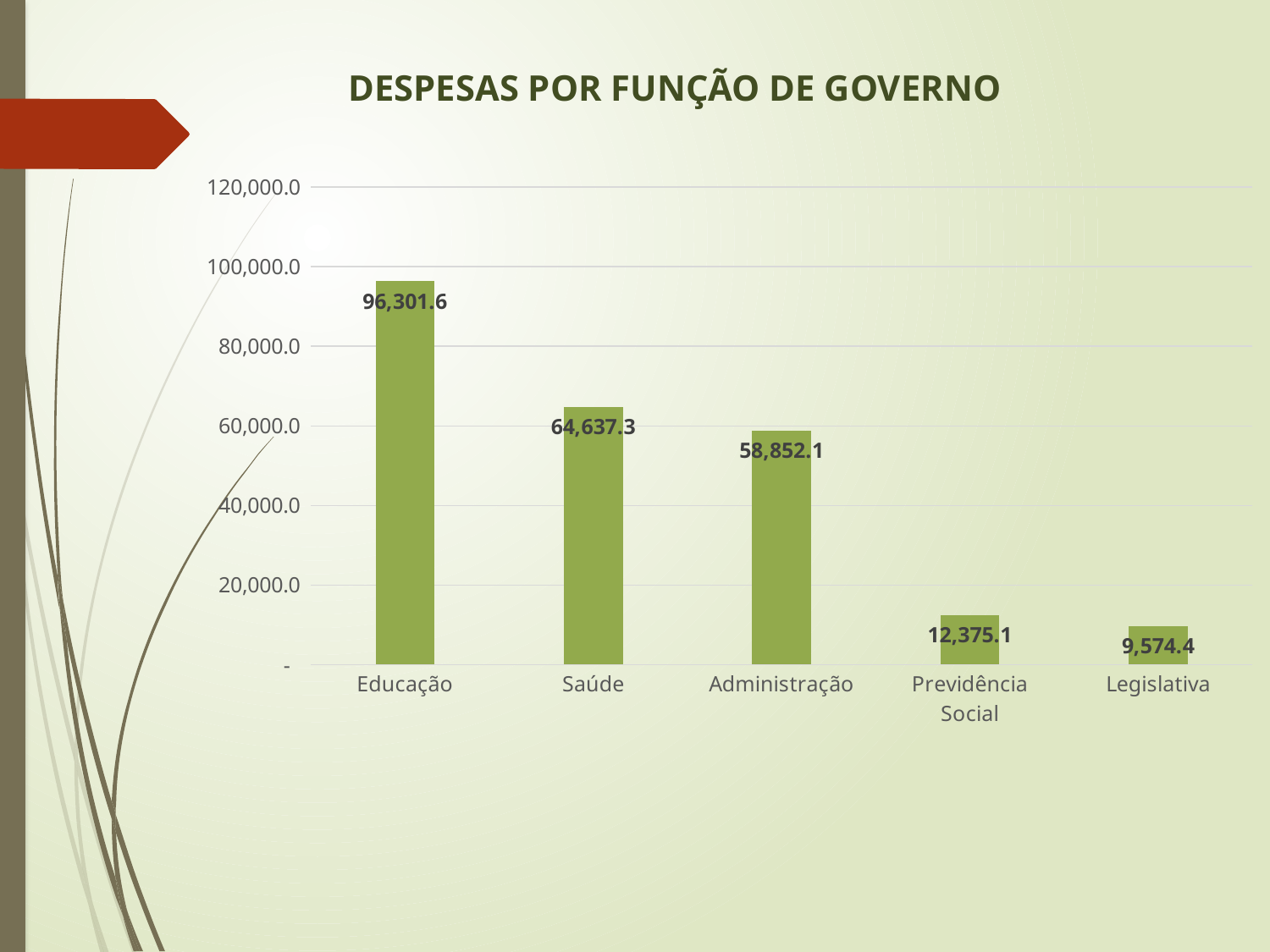
Which category has the lowest value? Legislativa What is the value for Educação? 96,301.6 What is the value for Legislativa? 9,574.4 Which is larger, the value for Administração or the value for Previdência Social? Administração What is the difference between the values for Educação and Saúde? 31,664.3 Which category has the highest value? Educação How many categories are shown on the x axis? 5 What is the difference between the values for Saúde and Administração? 5,785.2 What is the value for Saúde? 64,637.3 What kind of chart is shown on the slide? Bar chart What is the value for Previdência Social? 12,375.1 What is the title of the chart? DESPESAS POR FUNÇÃO DE GOVERNO